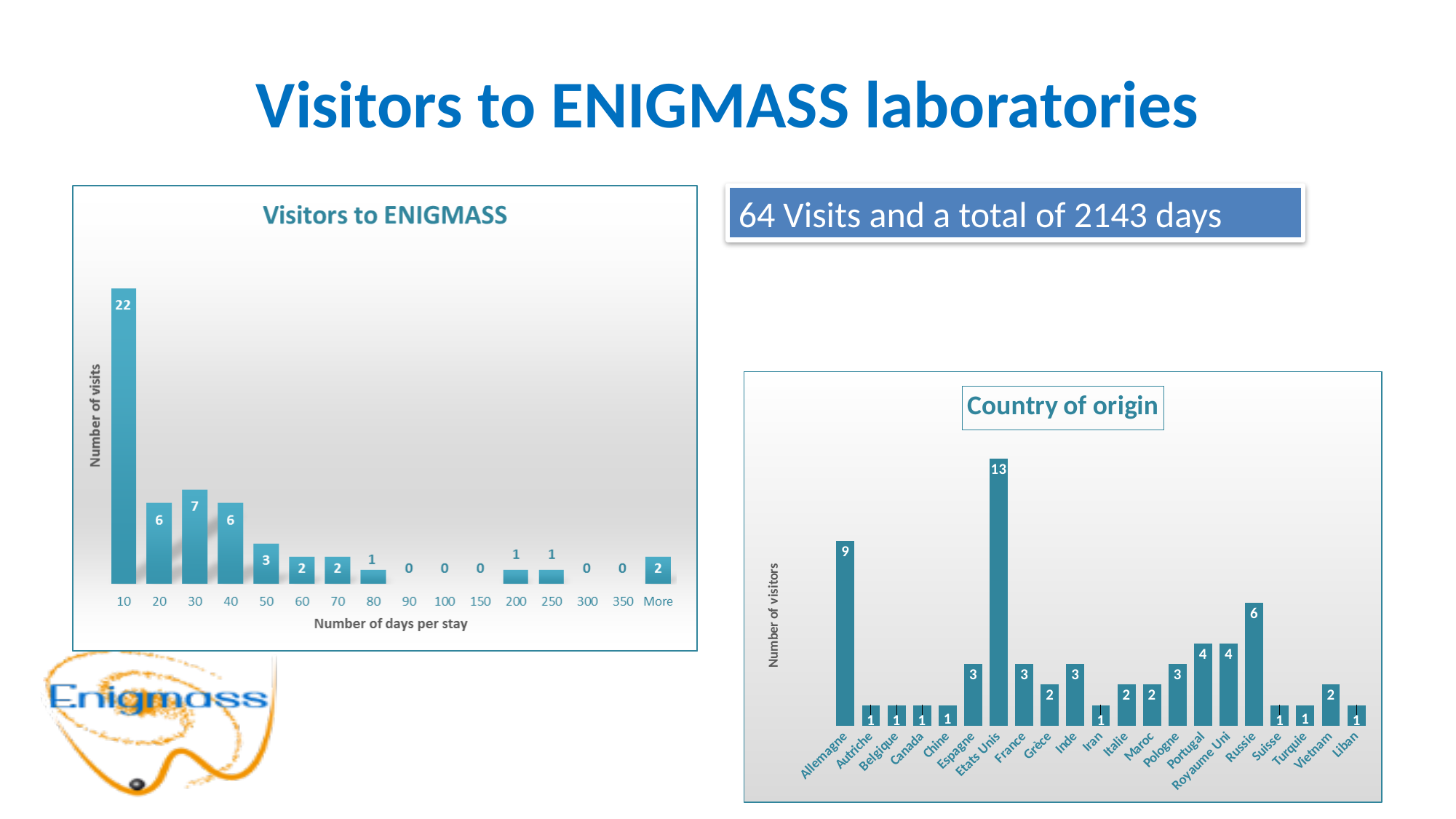
In the 'Country of origin' chart, which has more visitors, Portugal or Pologne? Portugal In the 'Visitors to ENIGMASS' chart, how many categories are shown on the x axis? 16 In the 'Visitors to ENIGMASS' chart, which number-of-days category has the highest number of visits? 10 In the 'Visitors to ENIGMASS' chart, what is the value for the 'More' category? 2 In the 'Visitors to ENIGMASS' chart, what is the difference between the visits for 10 days and for 20 days? 16 In the 'Country of origin' chart, which country has the highest number of visitors? Etats Unis In the 'Country of origin' chart, how many visitors came from Allemagne? 9 What type of chart is the 'Country of origin' chart? Bar chart In the 'Visitors to ENIGMASS' chart, how many visits had a stay of 10 days? 22 In the 'Visitors to ENIGMASS' chart, how many visits are shown for the 30-day category? 7 In the 'Country of origin' chart, what is the difference between the visitors from Etats Unis and from Allemagne? 4 In the 'Country of origin' chart, how many visitors came from Russie? 6